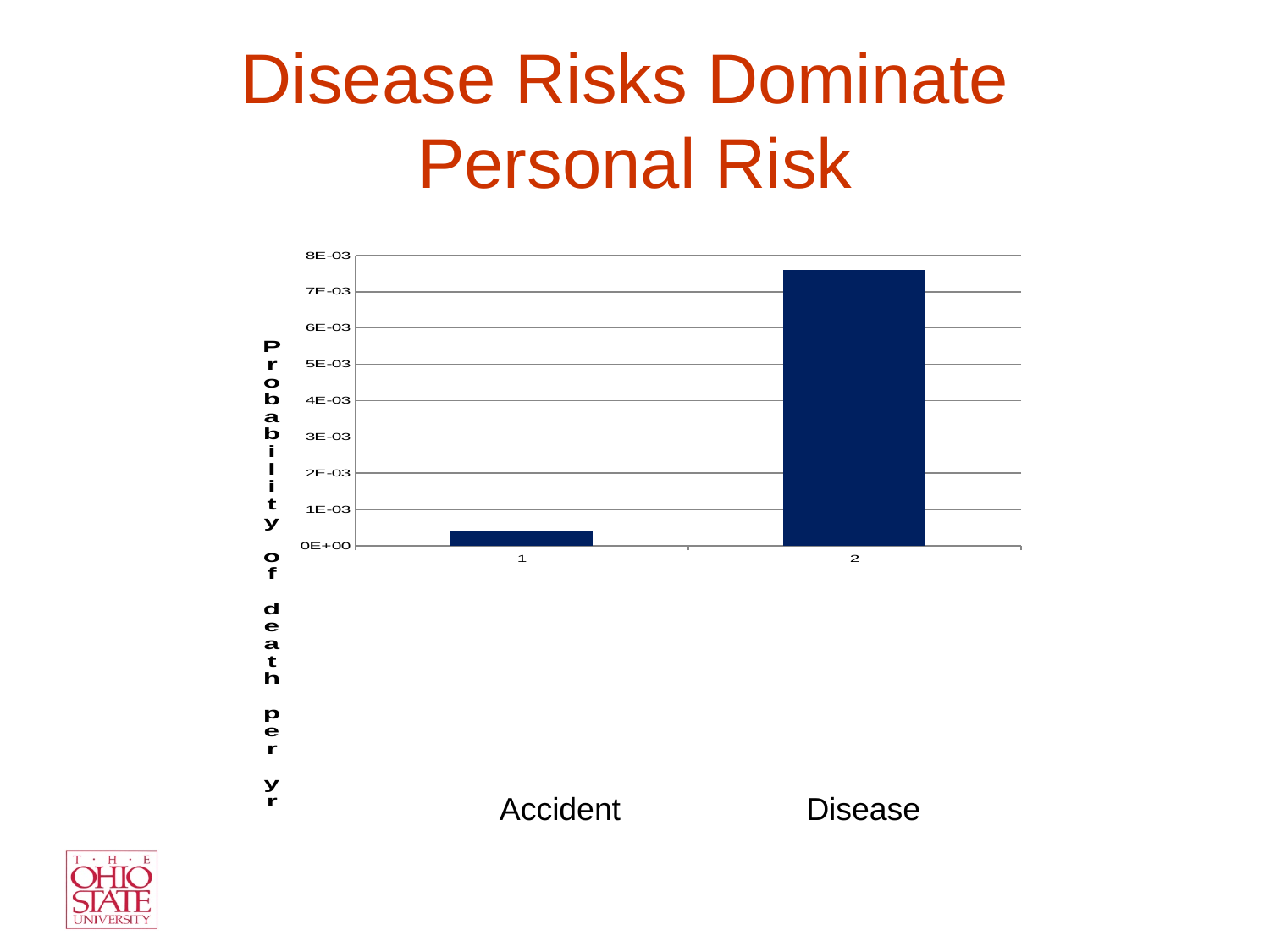
Is the value for Disease greater or less than 7E-03? greater Is the value for Accident greater or less than 0E+00? greater What is the title of the slide containing the chart? Disease Risks Dominate Personal Risk What is the label on the vertical axis of the chart? Probability of death per yr Is the value for Disease greater or less than 8E-03? less What kind of chart is shown on the slide? bar chart Which category has the lowest probability of death per year? Accident How many bars are plotted in the chart? 2 Which category has the highest probability of death per year, Accident or Disease? Disease Is the value for Disease larger or smaller than the value for Accident? larger What is the highest tick value shown on the vertical axis? 8E-03